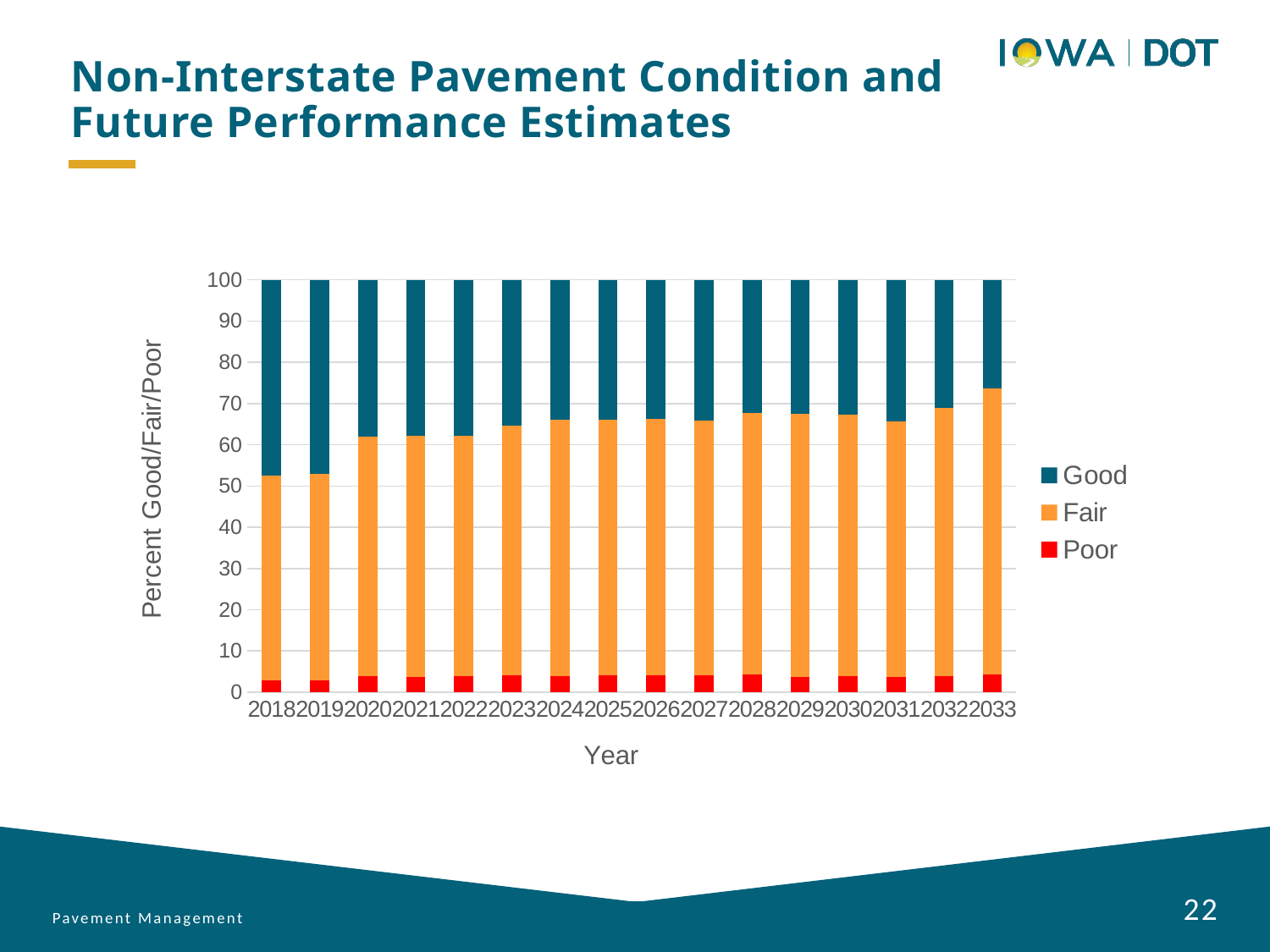
What are the three series listed in the chart's legend? Good, Fair, Poor What is the total height of each stacked bar in the chart? 100 Which year has the larger Fair segment, 2019 or 2033? 2033 Is the Poor value for 2018 greater or less than 10? less What kind of chart is shown on the slide? stacked bar chart How many years are shown along the x axis of the chart? 16 What is the label of the chart's vertical axis? Percent Good/Fair/Poor Which year has the larger Good segment, 2018 or 2033? 2018 Is the top of the Fair segment for 2018 greater or less than 60? less Does the Good segment generally rise or fall from 2018 to 2033? fall How many series does the chart's legend list? 3 Is the top of the Fair segment for 2033 greater or less than 70? greater